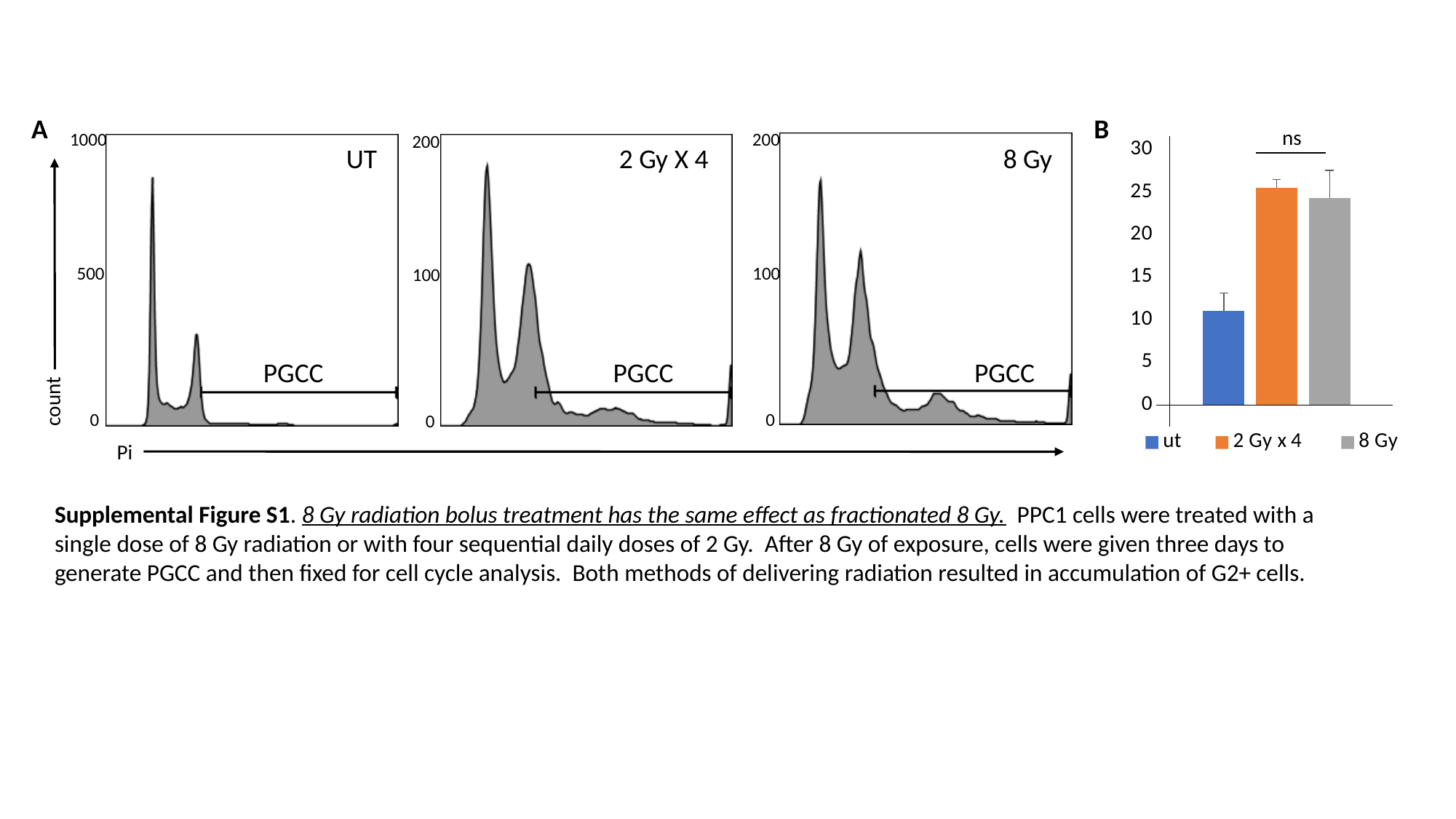
In the bar chart in panel B, is the value for ut greater or less than 15? less In the bar chart in panel B, which group has the lowest value? ut In the bar chart in panel B, is the value for ut greater or less than 5? greater In the bar chart in panel B, which is larger, the value for ut or the value for 2 Gy x 4? 2 Gy x 4 In the bar chart in panel B, how many bars are plotted? 3 In the bar chart in panel B, which is larger, the value for 8 Gy or the value for ut? 8 Gy In the bar chart in panel B, what annotation is shown above the 2 Gy x 4 and 8 Gy bars? ns In the bar chart in panel B, is the value for 2 Gy x 4 greater or less than 20? greater In the bar chart in panel B, what colour is the bar for 2 Gy x 4? orange In the bar chart in panel B, how many series does the legend list? 3 What kind of chart is panel B? bar chart